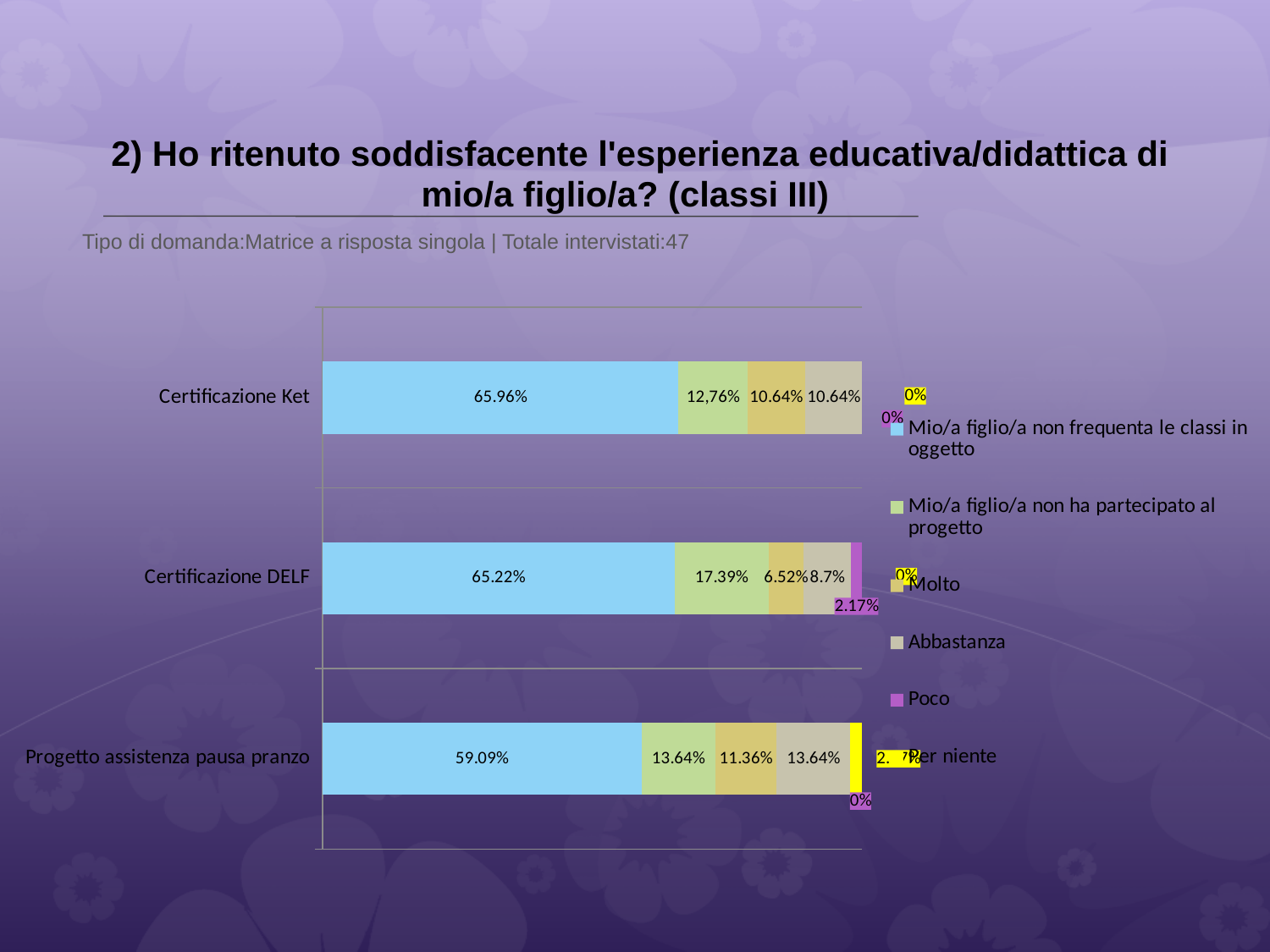
What is the value of 'Mio/a figlio/a non frequenta le classi in oggetto' for Certificazione Ket? 65.96% What is the difference between the 'Abbastanza' values for Certificazione Ket and Certificazione DELF? 1.94% Which is larger: the 'Abbastanza' value for Progetto assistenza pausa pranzo or for Certificazione DELF? Progetto assistenza pausa pranzo What kind of chart is shown on the slide? Stacked bar chart How many categories are plotted on the chart? 3 What is the value of 'Mio/a figlio/a non ha partecipato al progetto' for Certificazione DELF? 17.39% What is the 'Molto' value for Progetto assistenza pausa pranzo? 11.36% How many series does the legend list? 6 What is the 'Abbastanza' value for Certificazione Ket? 10.64% Which category has the lowest 'Molto' value? Certificazione DELF Which category has the highest value for 'Mio/a figlio/a non frequenta le classi in oggetto'? Certificazione Ket What is the 'Poco' value for Certificazione DELF? 2.17%